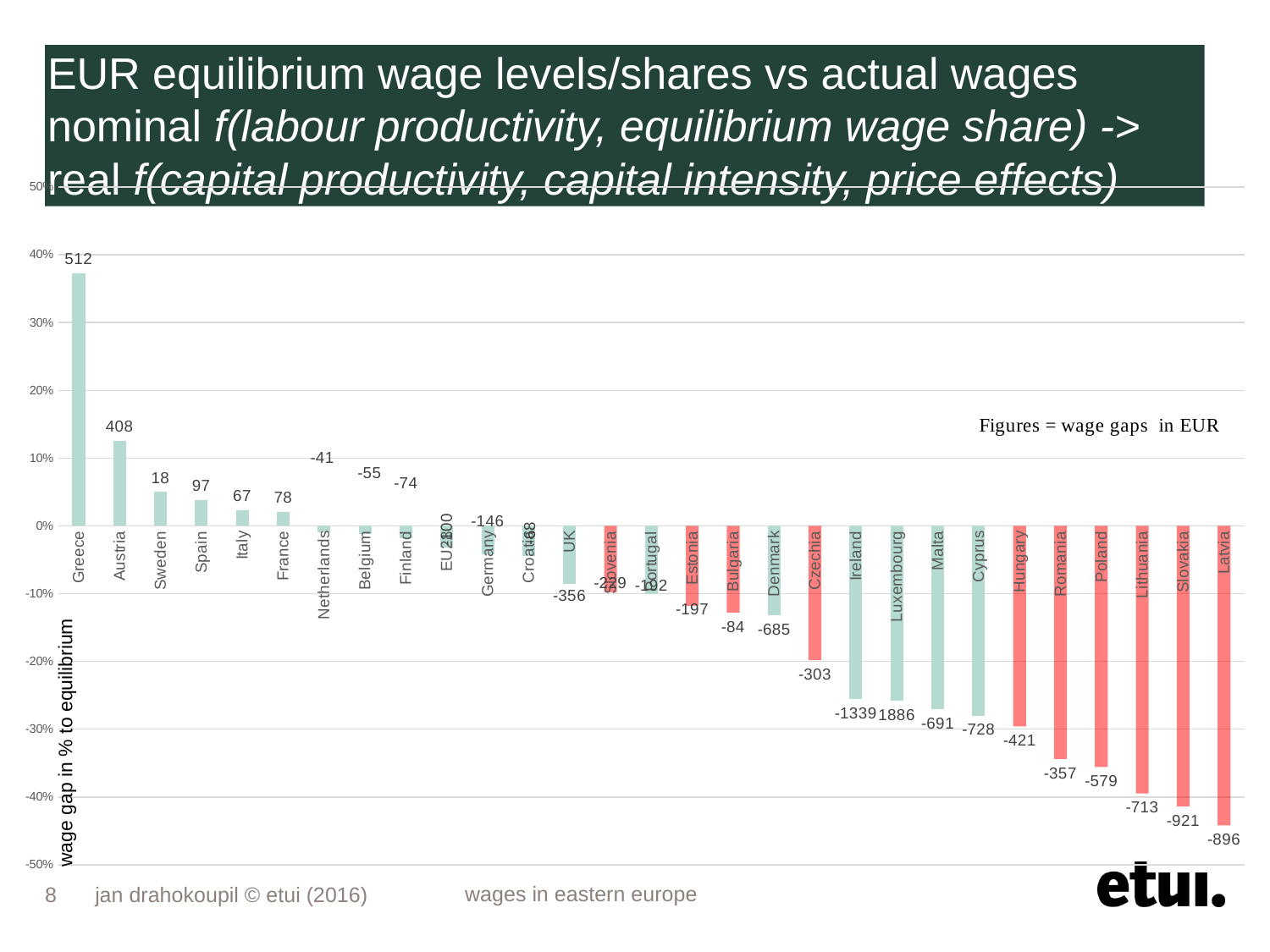
What wage gap in EUR is labelled for Greece? 512 Do the bars generally rise or fall moving from left to right along the x axis? fall Which country has the highest bar (largest positive wage gap in %)? Greece What kind of chart is shown on the slide? bar chart Which country has the lowest bar (most negative wage gap in %)? Latvia What wage gap in EUR is labelled for Sweden? 18 Is the wage gap in % for Latvia greater or less than -40%? less What is the difference between the EUR wage gap labels for Greece (512) and Austria (408)? 104 What wage gap in EUR is labelled for Slovakia? -921 What is the y-axis title of the chart? wage gap in % to equilibrium Is the wage gap in % for Greece greater or less than 30%? greater